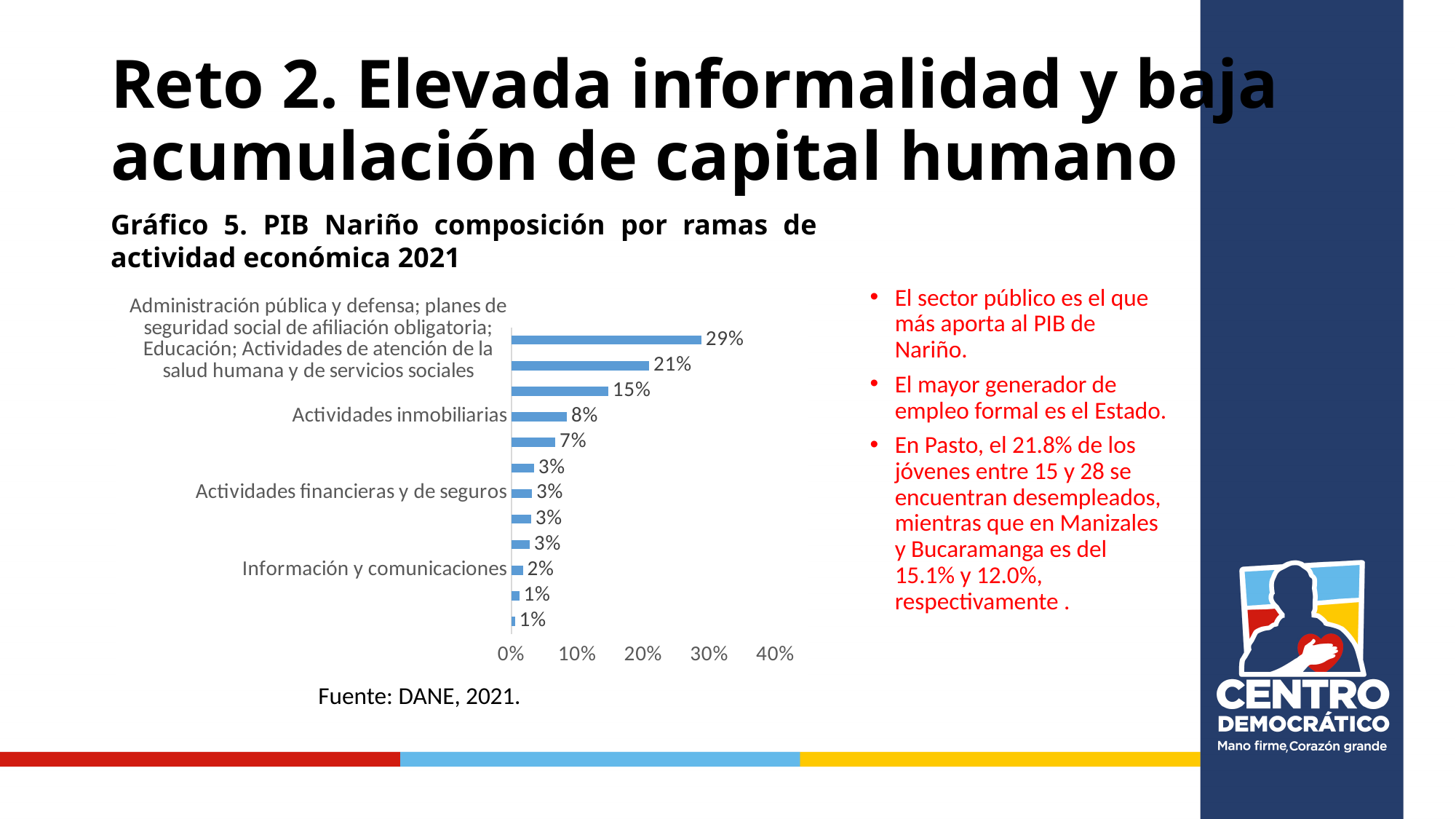
Is the value for 'Administración pública y defensa...' greater or less than 20%? greater What is the difference between the value for 'Actividades inmobiliarias' and the value for 'Información y comunicaciones'? 6 percentage points Which category has the highest value in the chart? Administración pública y defensa; planes de seguridad social de afiliación obligatoria; Educación; Actividades de atención de la salud humana y de servicios sociales What is the value for 'Actividades financieras y de seguros'? 3% What kind of chart is shown on the slide? Bar chart How many bars are plotted in the chart? 12 What is the value for 'Actividades inmobiliarias'? 8% What is the value for 'Información y comunicaciones'? 2% What is the value for 'Administración pública y defensa; planes de seguridad social de afiliación obligatoria; Educación; Actividades de atención de la salud humana y de servicios sociales'? 29% What is the title of the chart? Gráfico 5. PIB Nariño composición por ramas de actividad económica 2021 Which is larger, the value for 'Actividades inmobiliarias' or the value for 'Información y comunicaciones'? Actividades inmobiliarias What is the difference between the value for 'Administración pública y defensa...' and the value for 'Actividades inmobiliarias'? 21 percentage points